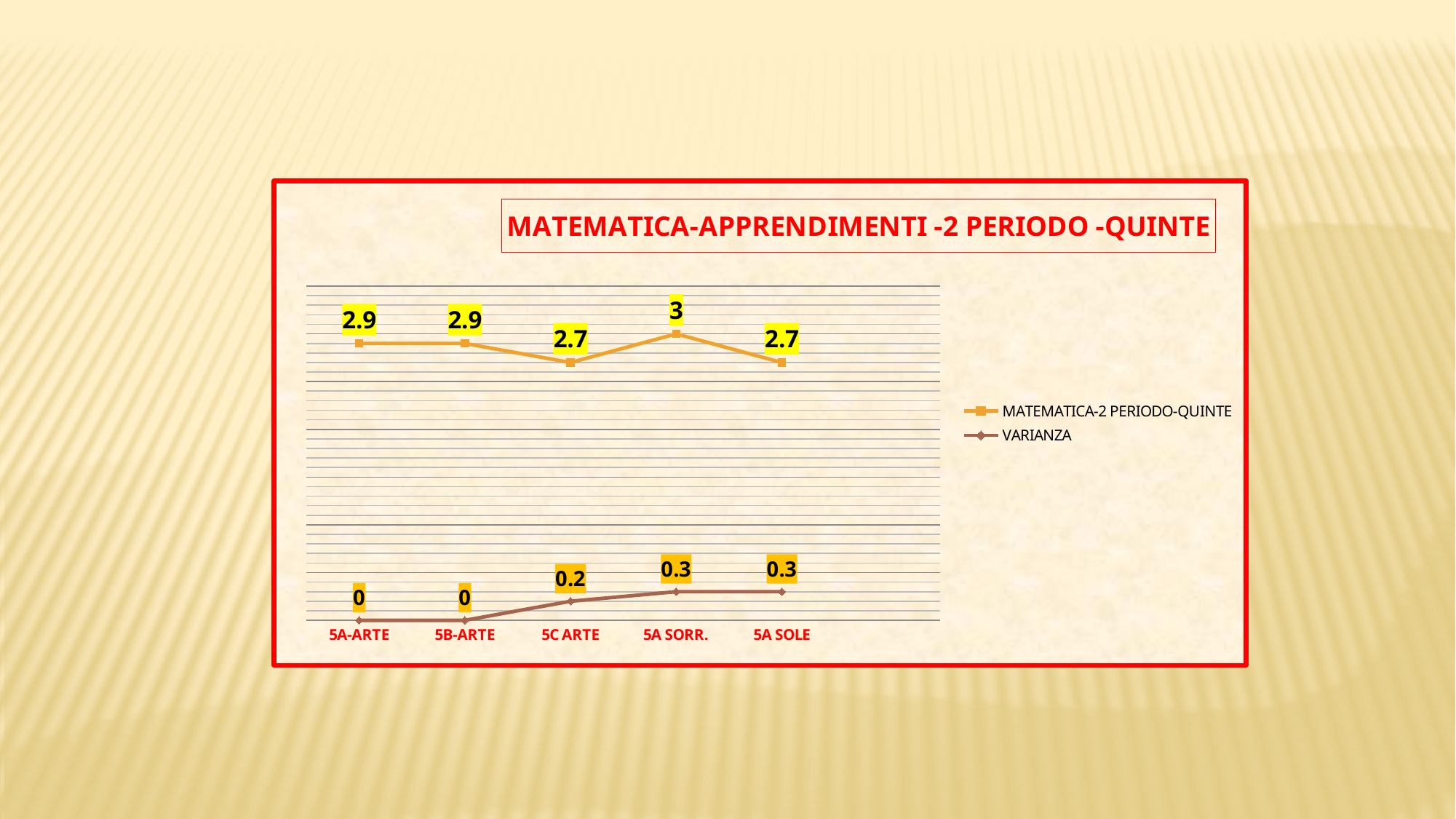
Does the VARIANZA series rise or fall from 5A-ARTE to 5A SOLE? rise Which is larger, the MATEMATICA-2 PERIODO-QUINTE value for 5A-ARTE or for 5A SOLE? 5A-ARTE What is the difference between the MATEMATICA-2 PERIODO-QUINTE values for 5A SORR. and 5C ARTE? 0.3 What is the VARIANZA value for 5B-ARTE? 0 How many categories are shown on the x axis? 5 What kind of chart is shown on the slide? line chart What is the title of the chart? MATEMATICA-APPRENDIMENTI -2 PERIODO -QUINTE Which category has the highest MATEMATICA-2 PERIODO-QUINTE value? 5A SORR. What is the MATEMATICA-2 PERIODO-QUINTE value for 5A SORR.? 3 How many series does the legend list? 2 What is the VARIANZA value for 5C ARTE? 0.2 What is the MATEMATICA-2 PERIODO-QUINTE value for 5A SOLE? 2.7